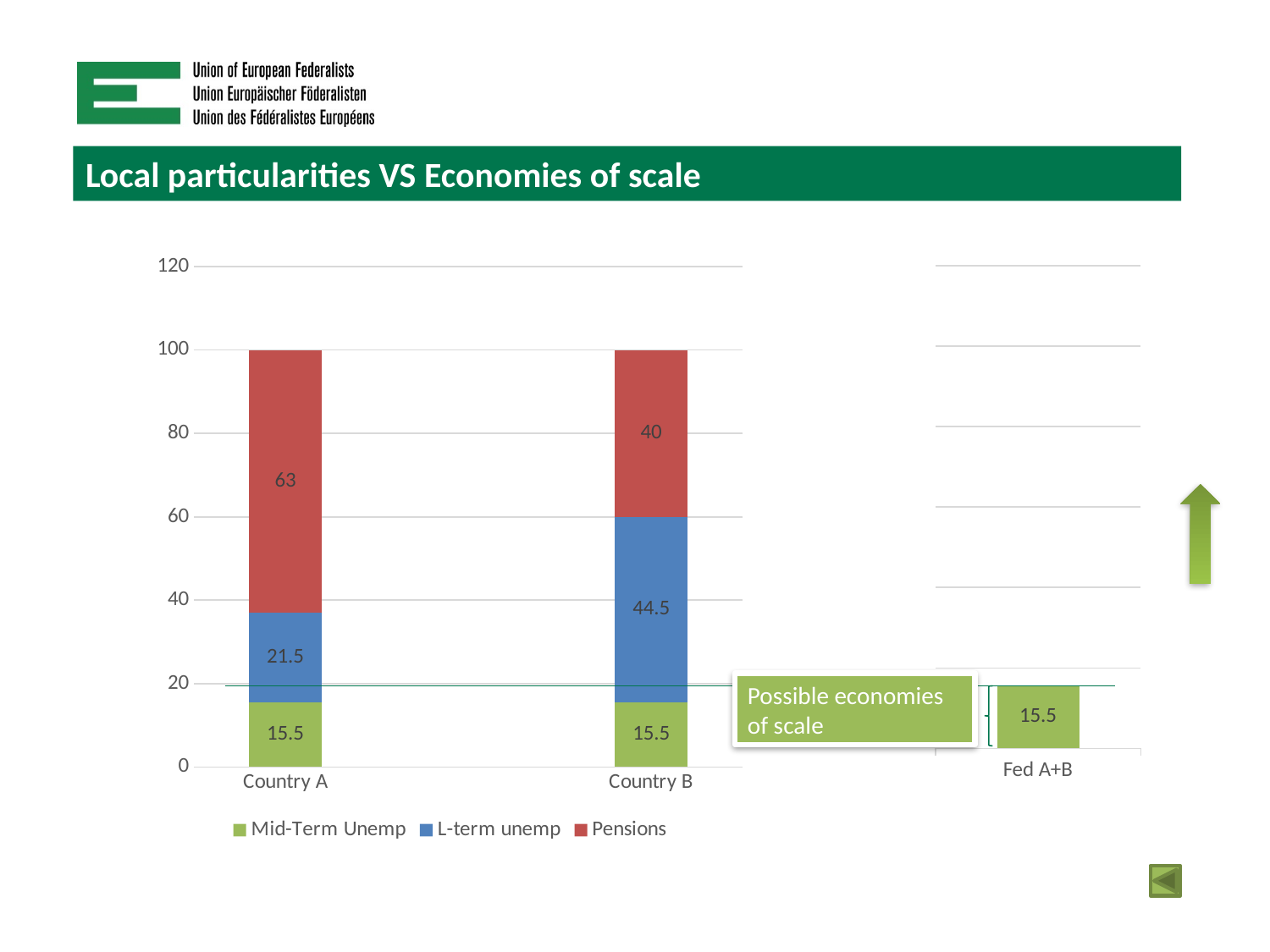
How many categories are shown on the x axis of the left chart? 2 On the left chart, is the L-term unemp value for Country A greater or less than 40? less On the left chart, what is the Mid-Term Unemp value for Country A? 15.5 On the left chart, what is the total of the stacked bar for Country B? 100 On the left chart, what is the difference between the Pensions values for Country A and Country B? 23 On the left chart, which country has the higher Pensions value? Country A On the left chart, what is the Pensions value for Country A? 63 On the left chart, what is the L-term unemp value for Country B? 44.5 On the left chart, which country has the larger L-term unemp value? Country B On the right chart, what is the value shown for Fed A+B? 15.5 What kind of chart is the left chart? Stacked bar chart How many series does the legend of the left chart list? 3